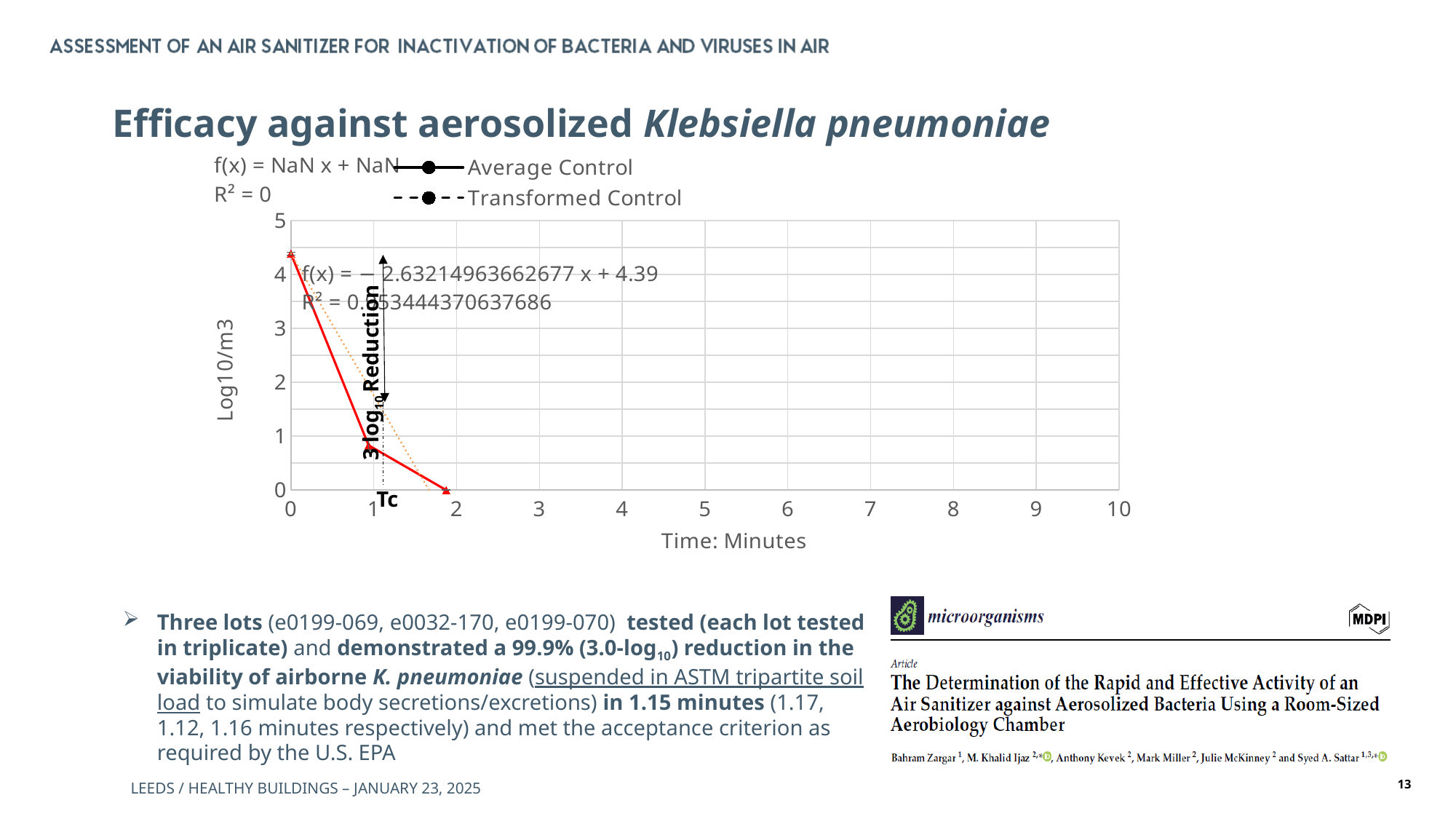
How many data points are plotted on the red line in the chart? 3 Do the plotted values rise or fall as time increases along the x axis? fall What is the label of the x axis of the chart? Time: Minutes What is the highest value shown on the x axis of the chart? 10 What is the highest value shown on the y axis of the chart? 5 Is the plotted value at time 1 minute greater or less than 2? less Is the plotted value at time 0 minutes greater or less than 4? greater What kind of chart is shown on the slide? line chart How many series does the chart legend list? 2 What is the intercept (constant term) of the fitted trendline equation f(x) = −2.63214963662677 x + ... shown on the chart? 4.39